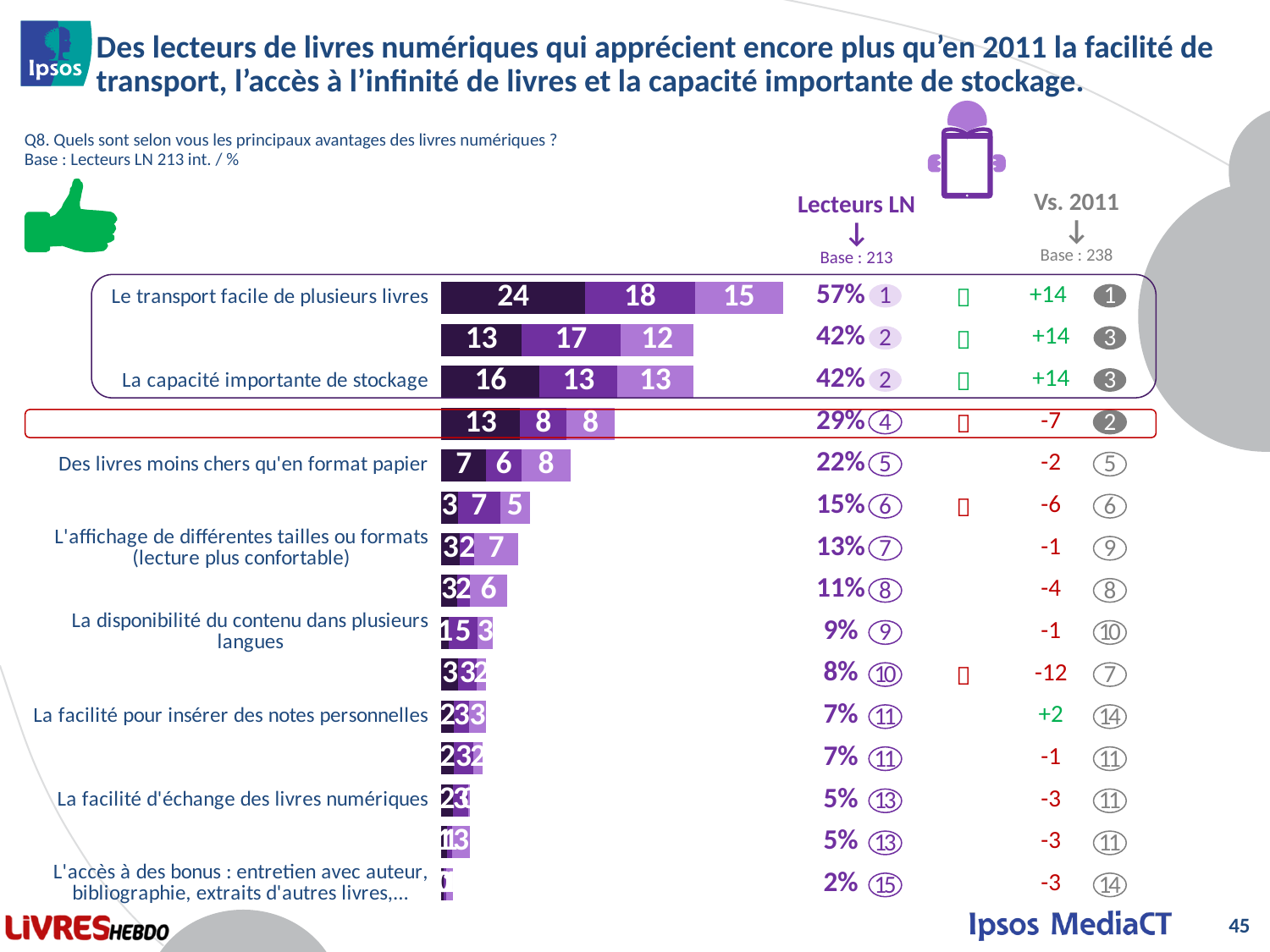
What is the value of the first (darkest) segment of the bar for "Le transport facile de plusieurs livres"? 24 What is the difference in total percentage between "Le transport facile de plusieurs livres" and "La capacité importante de stockage"? 15% Which has a higher total percentage: "Des livres moins chers qu'en format papier" or "La facilité pour insérer des notes personnelles"? Des livres moins chers qu'en format papier What is the change versus 2011 shown for "Le transport facile de plusieurs livres"? +14 How many bars are plotted in the chart? 15 What is the total percentage shown for "La capacité importante de stockage"? 42% What is the total percentage shown for "La disponibilité du contenu dans plusieurs langues"? 9% What type of chart is used to show the advantages of digital books? bar chart What is the total percentage shown for "Des livres moins chers qu'en format papier"? 22% Which category has the highest total percentage? Le transport facile de plusieurs livres What is the total percentage shown for "Le transport facile de plusieurs livres"? 57% Which category has the lowest total percentage? L'accès à des bonus : entretien avec auteur, bibliographie, extraits d'autres livres,...